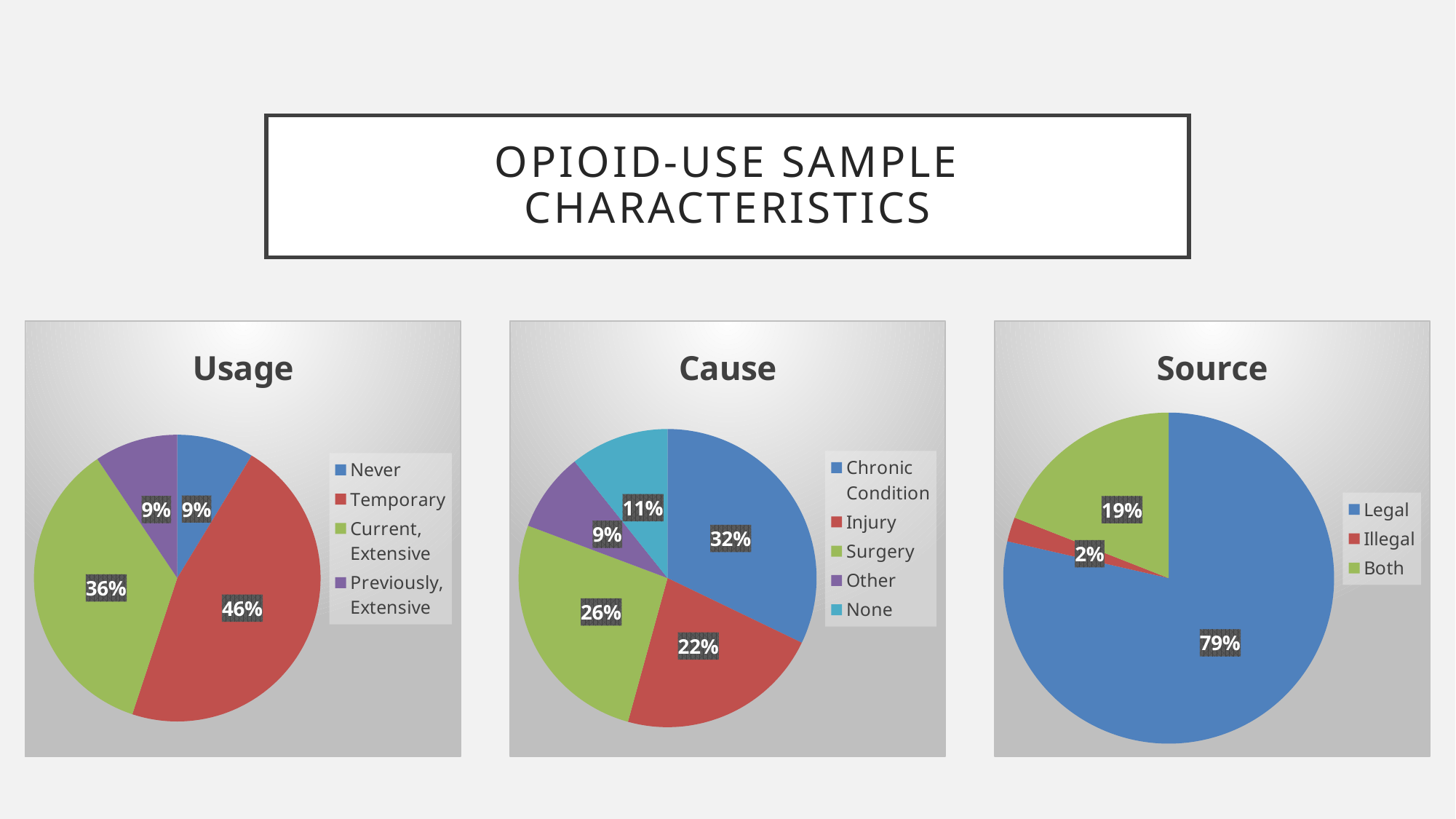
In the Source chart, what percentage is labelled for Both? 19% In the Cause chart, which category has the smallest slice? Other In the Cause chart, how many slices are there? 5 In the Usage chart, what is the difference between the Temporary and Current, Extensive slices? 10% In the Cause chart, which is larger, Injury or None? Injury In the Source chart, what is the difference between the Legal and Illegal slices? 77% In the Usage chart, what percentage is labelled for Temporary? 46% In the Cause chart, what percentage is labelled for Surgery? 26% In the Usage chart, which category has the largest slice? Temporary In the Usage chart, how many categories does the legend list? 4 What is the title of the chart on the left of the slide? Usage What kind of chart is the Source chart? Pie chart